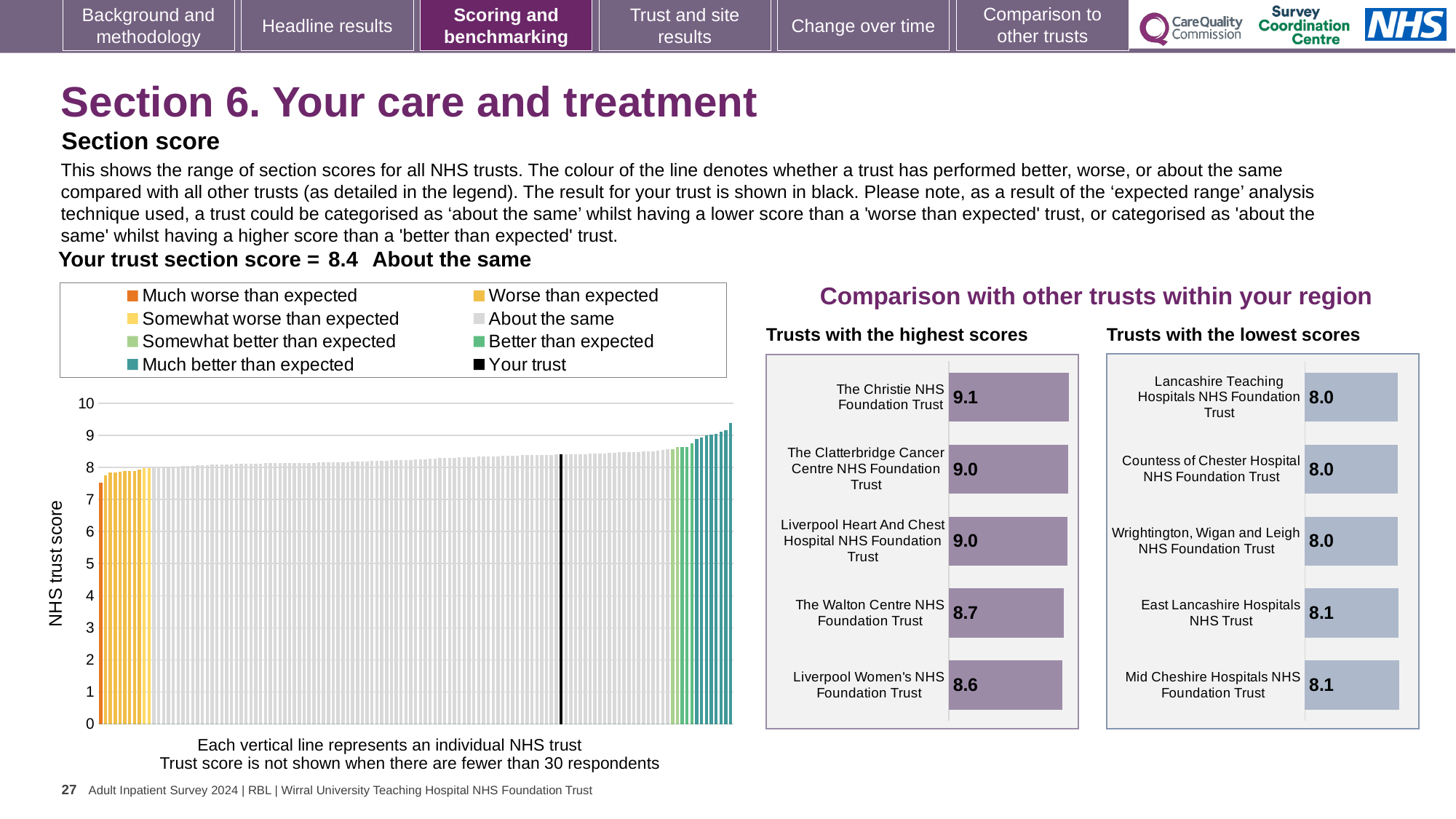
In the main chart of NHS trust scores on the left, do the trust scores rise or fall from left to right along the x axis? rise In the 'Trusts with the lowest scores' chart, what is the score for Countess of Chester Hospital NHS Foundation Trust? 8.0 In the 'Trusts with the highest scores' chart, what is the difference between the scores of The Christie NHS Foundation Trust and Liverpool Women's NHS Foundation Trust? 0.5 In the 'Trusts with the lowest scores' chart, what is the score for East Lancashire Hospitals NHS Trust? 8.1 In the 'Trusts with the lowest scores' chart, what is the difference between the scores of East Lancashire Hospitals NHS Trust and Lancashire Teaching Hospitals NHS Foundation Trust? 0.1 In the 'Trusts with the highest scores' chart, what is the score for The Christie NHS Foundation Trust? 9.1 What kind of chart is the 'Trusts with the highest scores' chart? bar chart In the 'Trusts with the highest scores' chart, what is the score for The Walton Centre NHS Foundation Trust? 8.7 In the 'Trusts with the lowest scores' chart, which is larger: the score for Mid Cheshire Hospitals NHS Foundation Trust or the score for Wrightington, Wigan and Leigh NHS Foundation Trust? Mid Cheshire Hospitals NHS Foundation Trust In the main chart of NHS trust scores on the left, how many entries does the legend list? 8 How many trusts are shown in the 'Trusts with the highest scores' chart? 5 In the 'Trusts with the highest scores' chart, which trust has the lowest score? Liverpool Women's NHS Foundation Trust